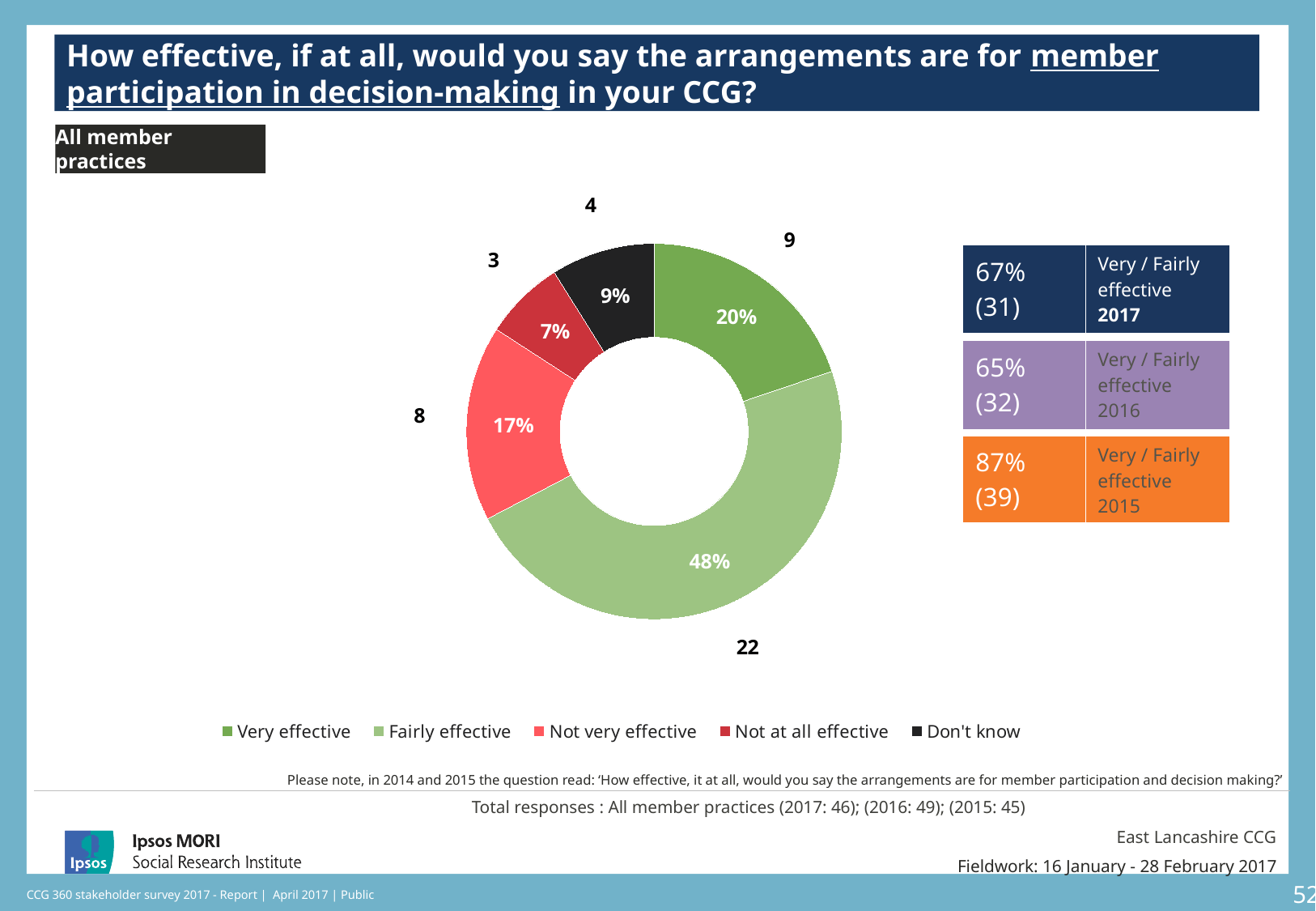
Which is larger, the share for 'Not very effective' or the share for 'Don't know'? Not very effective What colour is used for the 'Don't know' segment? Black Which response category has the smallest share of the chart? Not at all effective How many response categories does the legend list? 5 What kind of chart is shown on the slide? Doughnut chart What percentage of respondents said the arrangements are fairly effective? 48% What percentage of respondents answered 'Don't know'? 9% What percentage of respondents said the arrangements are very effective? 20% What is the combined percentage for 'Very effective' and 'Fairly effective'? 68% Which response category has the largest share of the chart? Fairly effective What is the difference in percentage points between 'Fairly effective' and 'Very effective'? 28 How many respondents said the arrangements are not very effective? 8